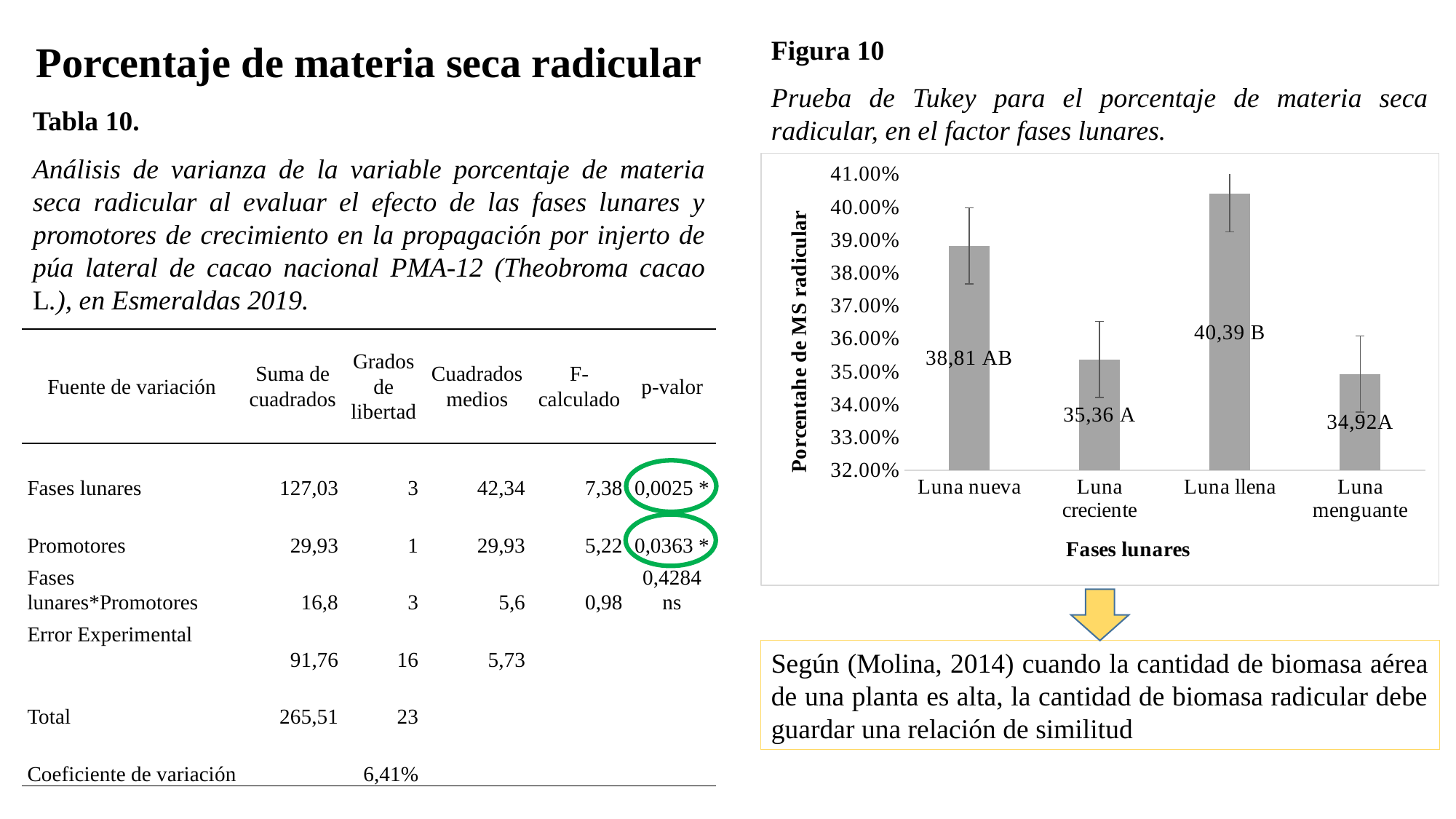
What is the value shown for Luna creciente in the Figura 10 bar chart? 35,36 What is the value shown for Luna llena in the Figura 10 bar chart? 40,39 How many lunar phases (categories) are plotted in the Figura 10 chart? 4 In the Figura 10 chart, which is larger: the value for Luna nueva or the value for Luna creciente? Luna nueva In the Figura 10 chart, what is the difference between the values for Luna llena and Luna menguante? 5,47 Which lunar phase has the highest percentage of root dry matter in the Figura 10 chart? Luna llena In the Figura 10 chart, is the value for Luna menguante greater or less than 36.00%? less What is the value shown for Luna nueva in the Figura 10 bar chart? 38,81 What is the value shown for Luna menguante in the Figura 10 bar chart? 34,92 Which lunar phase has the lowest percentage of root dry matter in the Figura 10 chart? Luna menguante What kind of chart is Figura 10? Bar chart In the Figura 10 chart, what is the difference between the values for Luna nueva and Luna creciente? 3,45